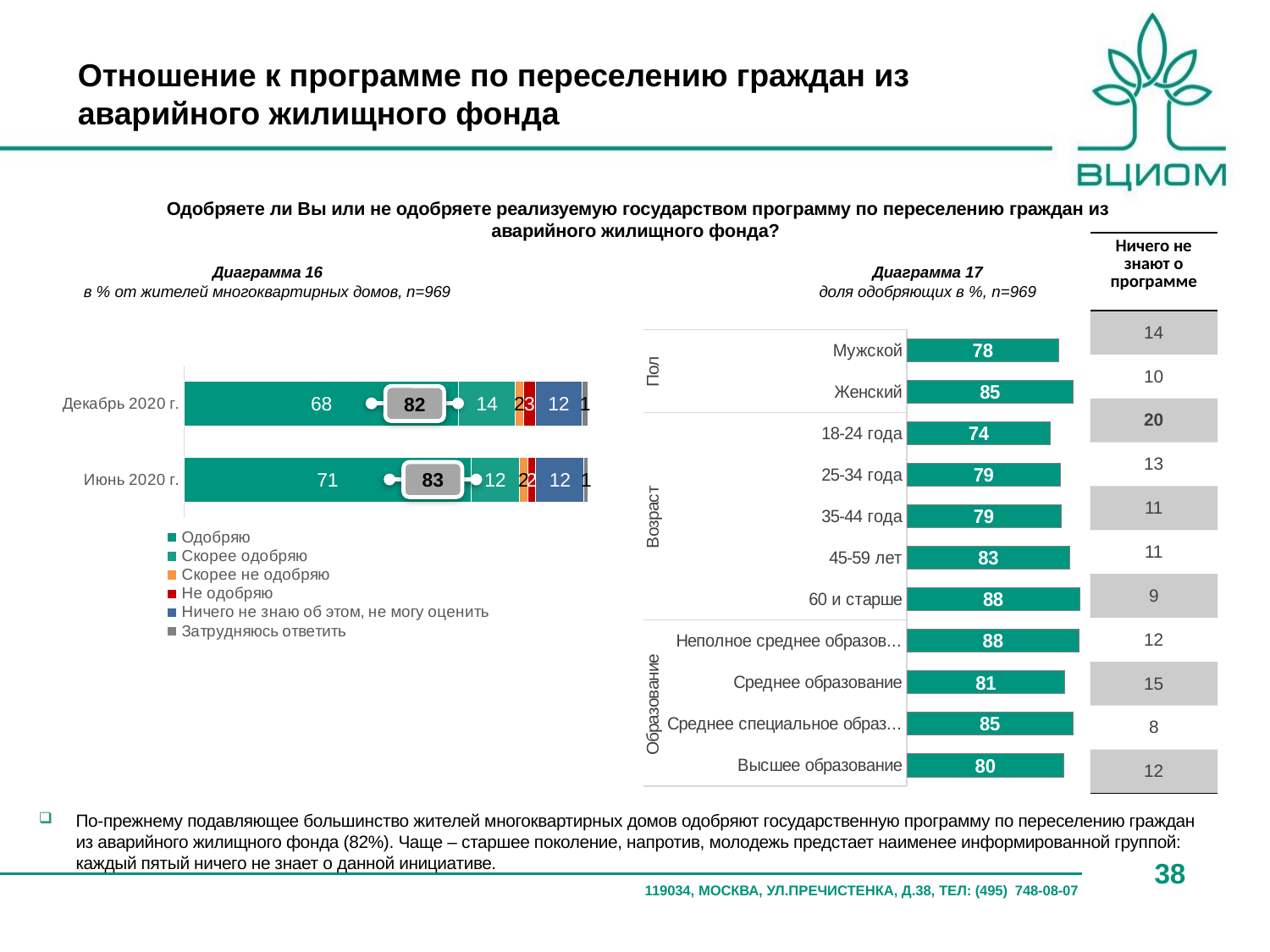
In Диаграмма 17, what is the share of approving respondents among Мужской? 78 In Диаграмма 17, what is the difference between the values for Женский and Мужской? 7 In Диаграмма 17, which age group has the lowest share of approving respondents? 18-24 года In Диаграмма 17, what is the value for 60 и старше? 88 In Диаграмма 17, which is larger: the value for Среднее образование or for Высшее образование? Среднее образование In Диаграмма 16, what is the value of the Скорее одобряю segment for Июнь 2020 г.? 12 What kind of chart is Диаграмма 17? Bar chart In Диаграмма 17, how many categories (bars) are plotted? 11 In Диаграмма 16, what is the value of the Одобряю segment for Декабрь 2020 г.? 68 How many series does the legend of Диаграмма 16 list? 6 In Диаграмма 17, what is the value for Женский? 85 In Диаграмма 16, what combined approval value is shown in the callout for Июнь 2020 г.? 83